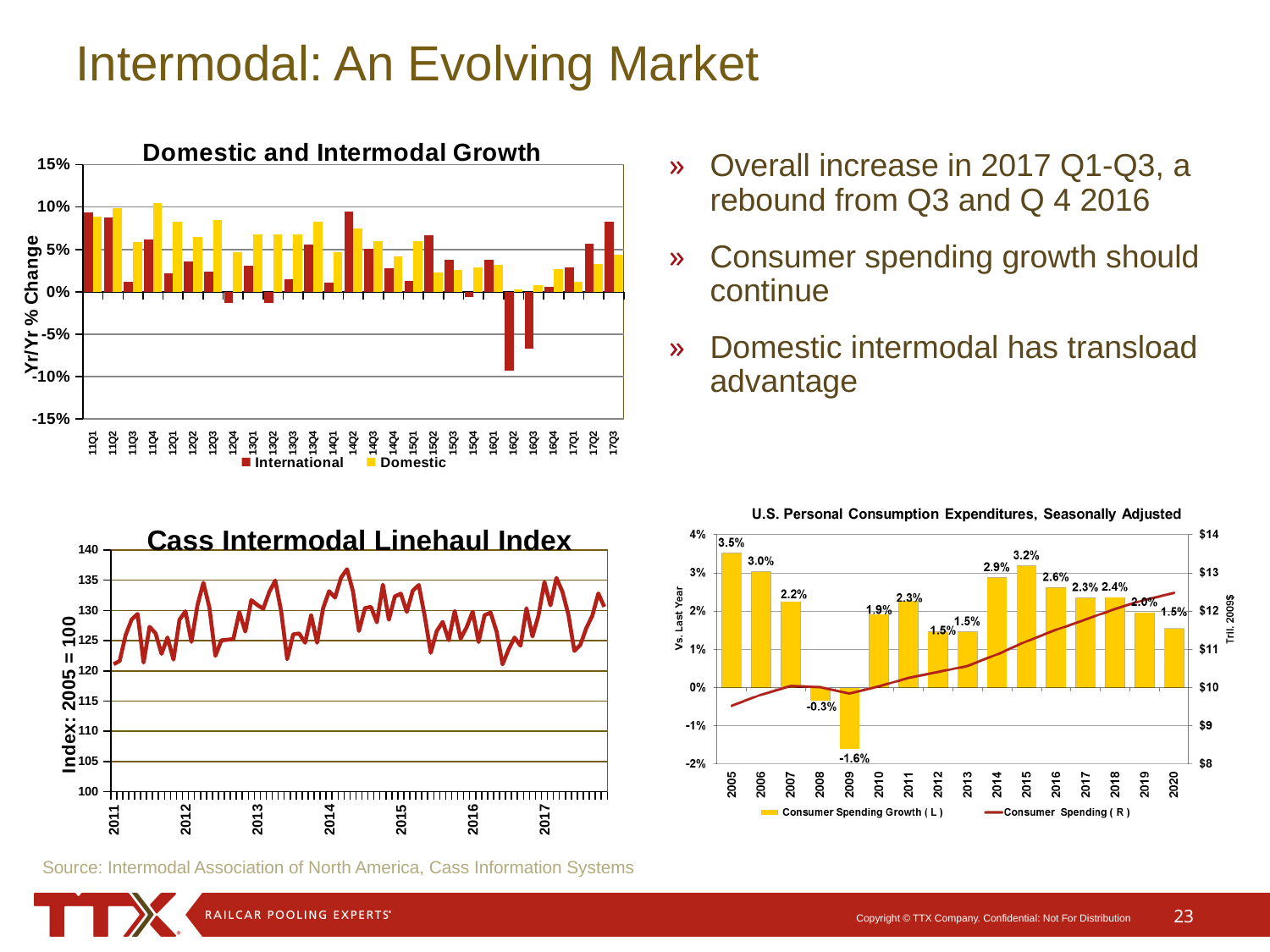
In the U.S. Personal Consumption Expenditures chart, which year has the lowest consumer spending growth? 2009 What kind of chart is the Cass Intermodal Linehaul Index chart? Line chart In the Domestic and Intermodal Growth chart, is the International value for 16Q2 greater or less than -5%? less In the U.S. Personal Consumption Expenditures chart, what is the consumer spending growth value for 2005? 3.5% In the U.S. Personal Consumption Expenditures chart, which year has the highest consumer spending growth? 2005 How many years are shown on the x axis of the U.S. Personal Consumption Expenditures chart? 16 In the Cass Intermodal Linehaul Index chart, is the value at the start of 2011 greater or less than 125? less How many series does the legend of the Domestic and Intermodal Growth chart list? 2 In the U.S. Personal Consumption Expenditures chart, what is the difference between the consumer spending growth in 2005 and in 2009? 5.1 percentage points In the U.S. Personal Consumption Expenditures chart, what is the consumer spending growth value for 2009? -1.6% What kind of chart is the Domestic and Intermodal Growth chart? Bar chart In the U.S. Personal Consumption Expenditures chart, which year has higher consumer spending growth, 2014 or 2015? 2015